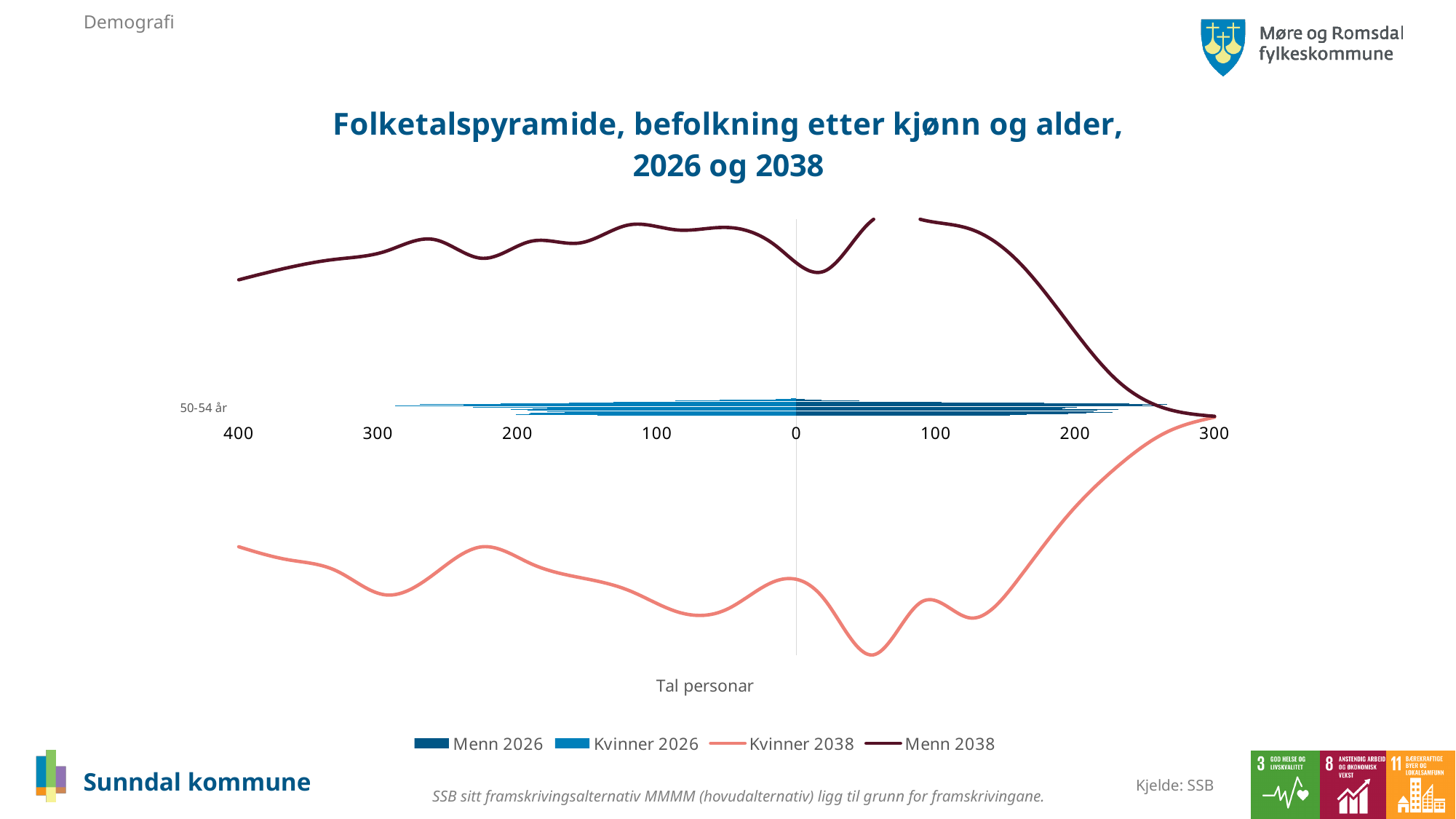
What is the title of the chart? Folketalspyramide, befolkning etter kjønn og alder, 2026 og 2038 Which age group label is readable on the vertical axis of the chart? 50-54 år What label is shown on the horizontal axis of the chart? Tal personar What is the largest tick value shown on the right side of the horizontal axis? 300 How many series does the chart's legend list? 4 What is the largest tick value shown on the left side of the horizontal axis? 400